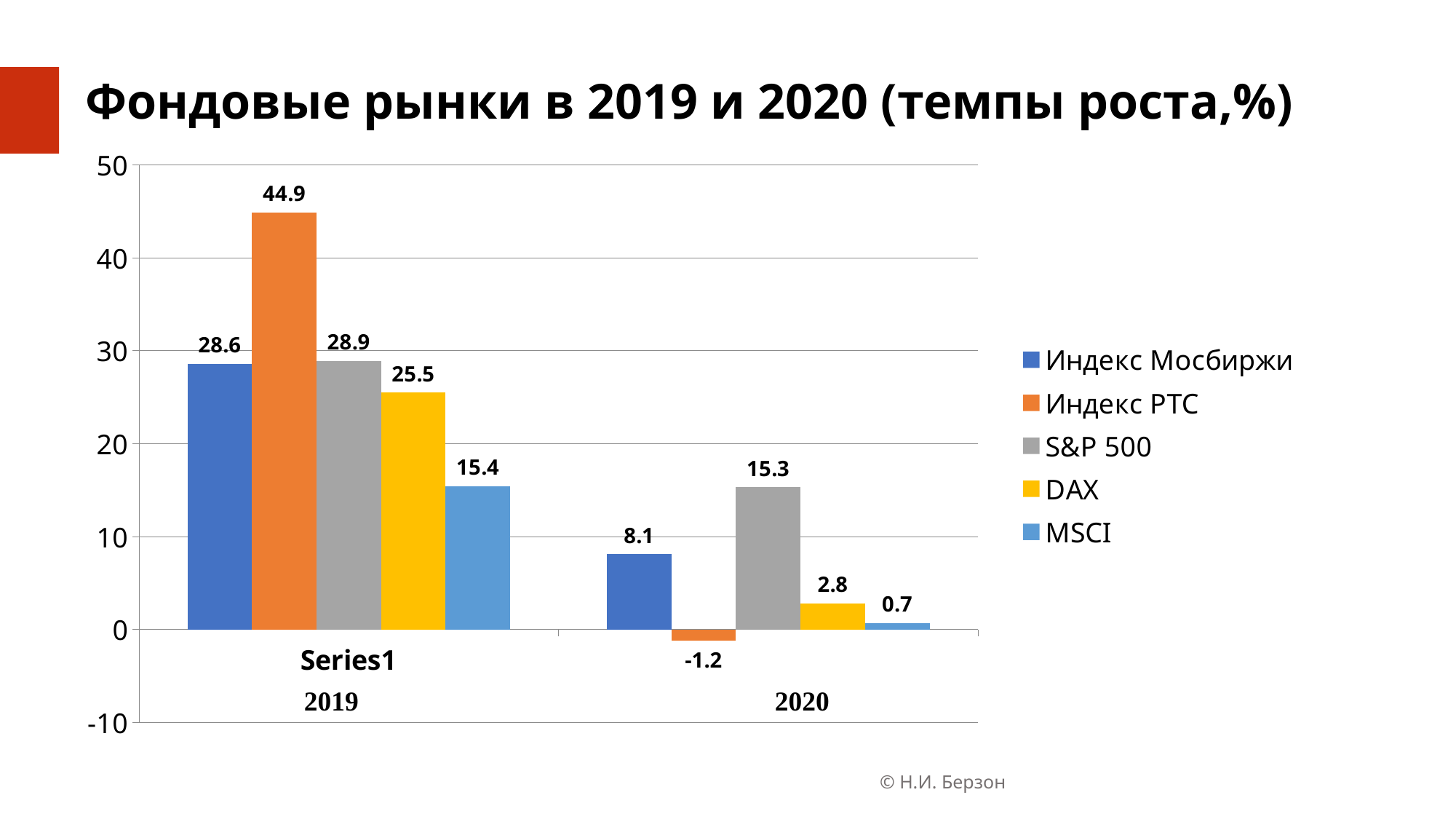
What is the value for S&P 500 in 2020? 15.3 What is the value for Индекс РТС in 2020? -1.2 Which series has the highest value in 2019? Индекс РТС How many series does the legend list? 5 What is the title of the chart? Фондовые рынки в 2019 и 2020 (темпы роста,%) What kind of chart is shown on the slide? Bar chart Which is larger: Индекс Мосбиржи in 2019 or S&P 500 in 2019? S&P 500 in 2019 What is the value for Индекс РТС in 2019? 44.9 What is the difference between the DAX values in 2019 and 2020? 22.7 Does the value for Индекс Мосбиржи rise or fall from 2019 to 2020? Fall Which series has the lowest value in 2020? Индекс РТС What is the value for MSCI in 2019? 15.4